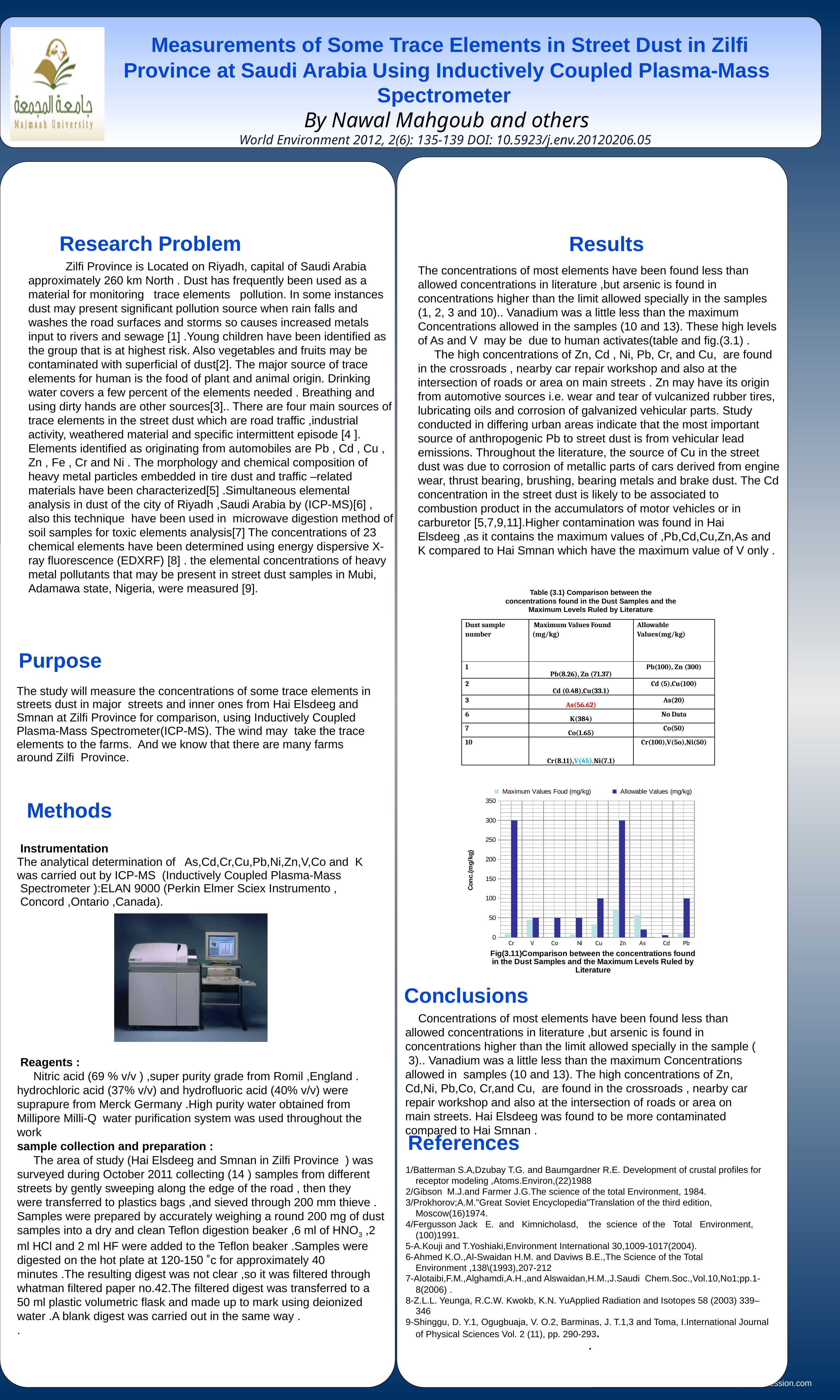
What is the first entry in the chart's legend? Maximum Values Foud (mg/kg) What kind of chart is Fig(3.11) on the slide? bar chart Is the Allowable Value for As greater or less than 50? less Which element has the lowest Allowable Value in the chart? Cd What is the label on the y axis of the chart? Conc.(mg/kg) Which is larger in the chart, the Allowable Value for Zn or the Allowable Value for As? Zn What is the Allowable Value (mg/kg) for Zn in the chart? 300 Which is larger in the chart, the Allowable Value for Cu or the Allowable Value for Ni? Cu How many elements are shown along the x axis of the chart? 9 Is the Maximum Value Found for Zn greater or less than 50? greater How many series does the legend of the chart list? 2 Is the Maximum Value Found for Cu greater or less than 50? less